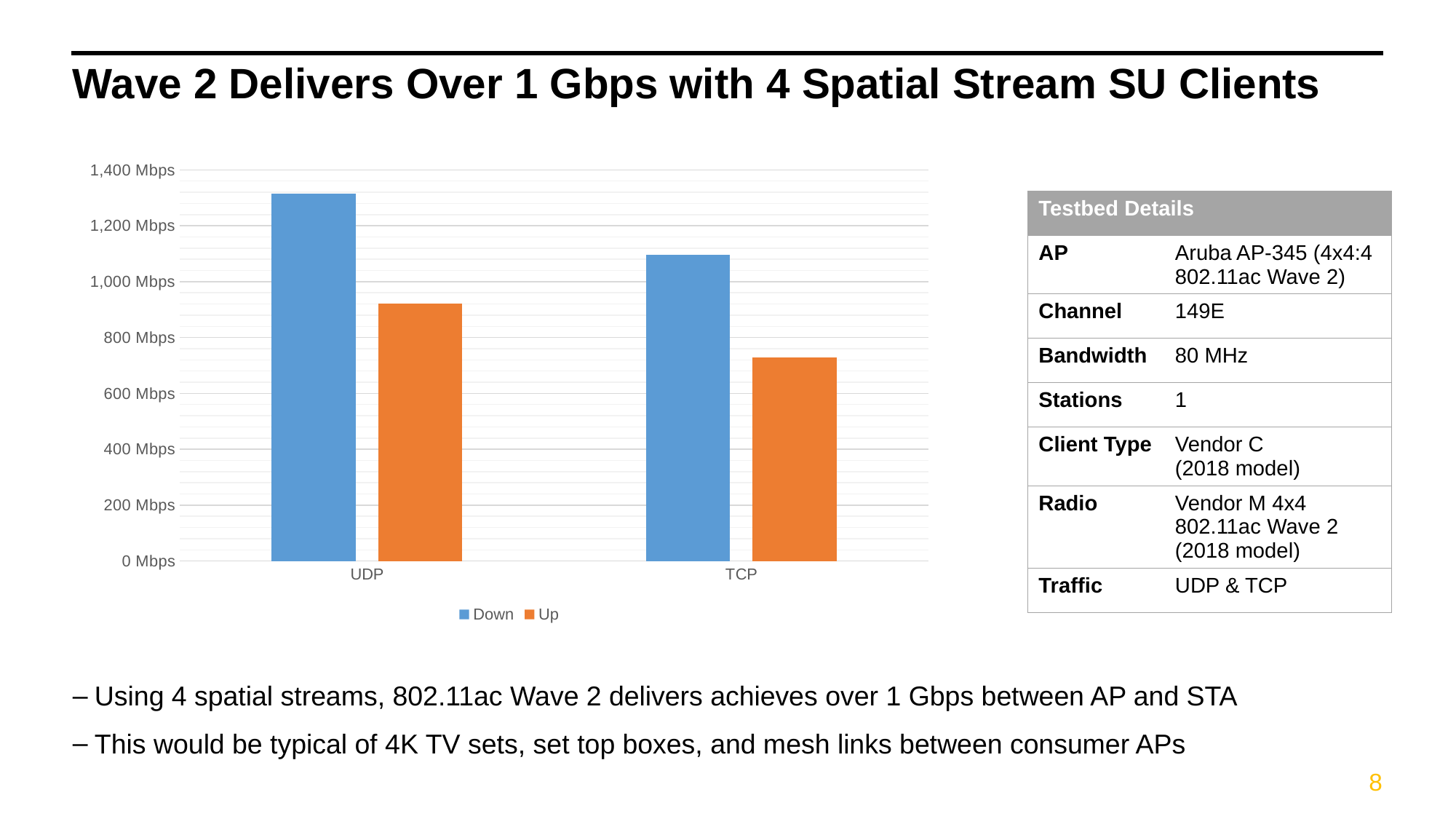
Is the Down value for UDP greater or less than 1,200 Mbps? greater How many categories are shown on the x axis of the chart? 2 Is the Down value for TCP greater or less than 1,000 Mbps? greater Which category has the highest Down value? UDP Is the Up value for TCP greater or less than 800 Mbps? less Which series is shown in orange in the chart? Up What is the unit shown on the y axis of the chart? Mbps Which is larger, the Down value for TCP or the Up value for UDP? Down value for TCP How many series does the chart legend list? 2 What kind of chart is shown on the slide? bar chart Which category has the lowest Up value? TCP